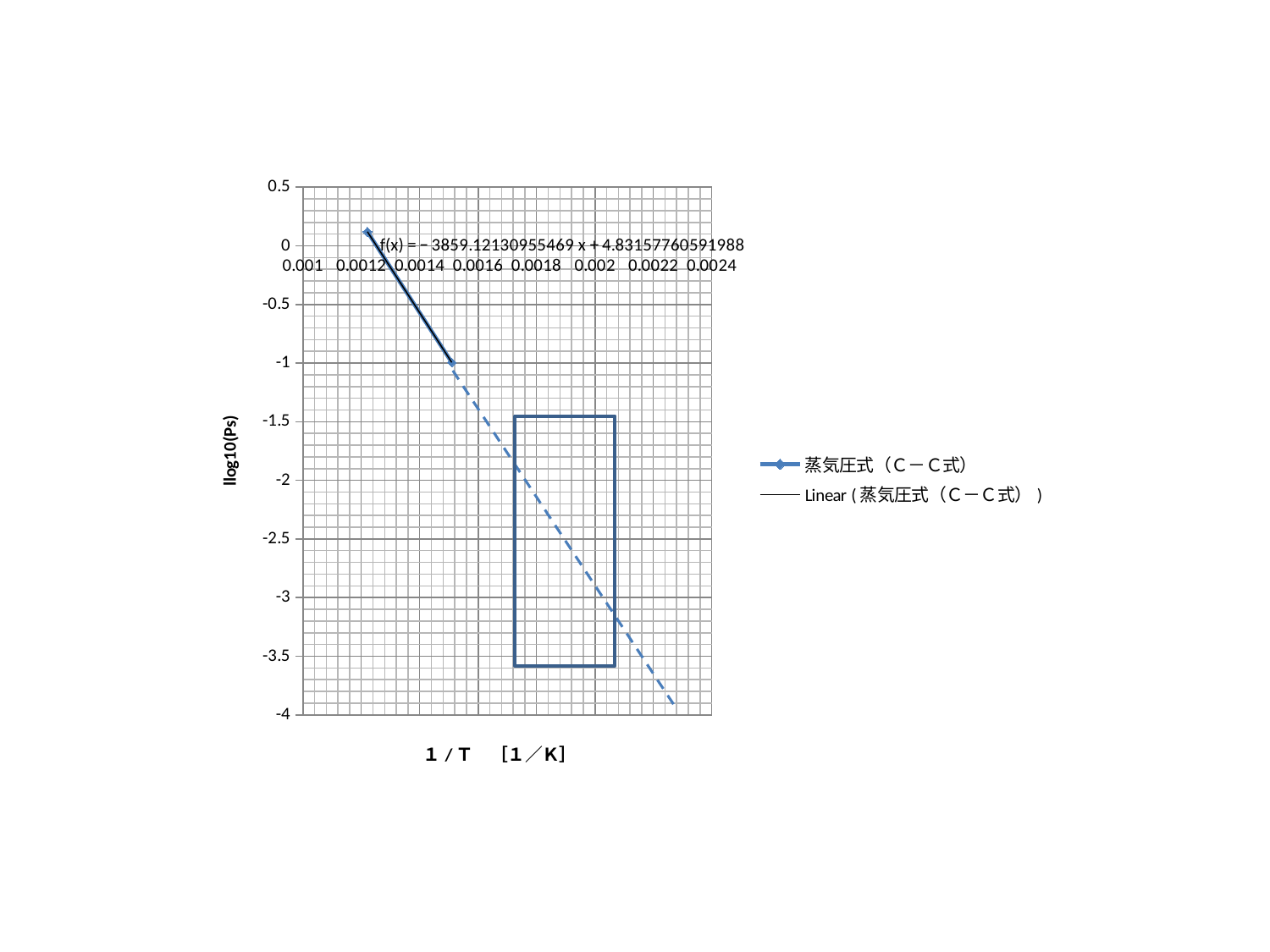
What is the lowest value shown on the y axis? -4 Is the value of the 蒸気圧式（C－C式） series at 1/T = 0.0012 greater or less than 0? greater What is the intercept of the linear trendline shown on the chart? 4.83157760591988 Do the plotted values rise or fall as 1/T increases along the x axis? fall What is the slope of the linear trendline shown on the chart? −3859.12130955469 Is the value of the 蒸気圧式（C－C式） series at 1/T = 0.0015 greater or less than -0.5? less What is the trendline equation displayed on the chart? f(x) = − 3859.12130955469 x + 4.83157760591988 What is the title of the x axis? 1 / T [1／K] How many series does the legend list? 2 What kind of chart is shown on the slide? line chart Which is larger for the 蒸気圧式（C－C式） series: the value at 1/T = 0.0012 or at 1/T = 0.0015? 1/T = 0.0012